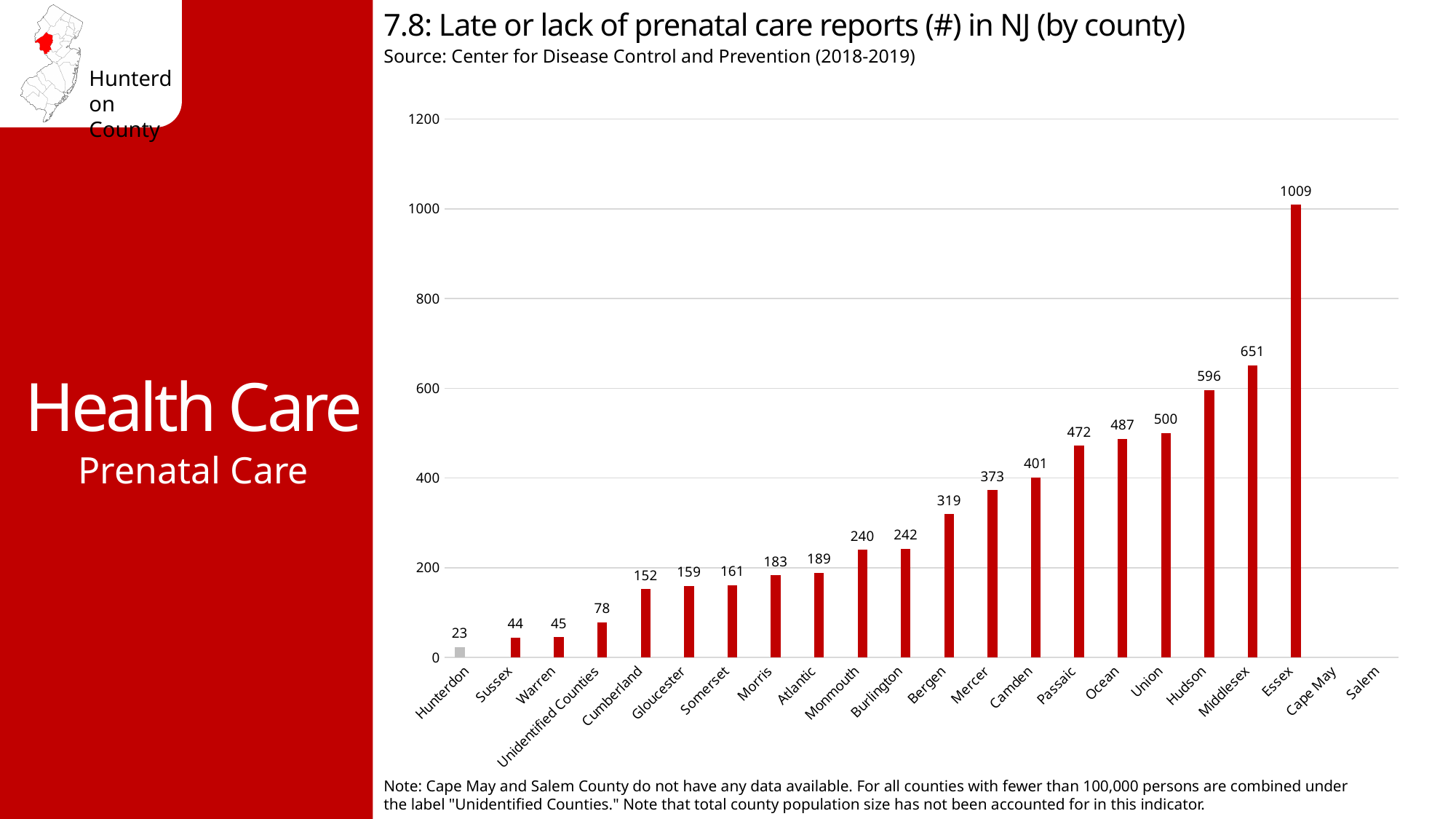
Which has a larger value, Hudson or Union? Hudson Is the value for Bergen greater or less than 400? less What kind of chart is shown on the slide? Bar chart Which county has the highest number of late or lack of prenatal care reports? Essex What is the number of late or lack of prenatal care reports for Hunterdon? 23 What is the value shown for Unidentified Counties? 78 What is the difference between the values for Essex and Middlesex? 358 What is the value shown for Essex? 1009 How many county categories are labeled on the x axis? 22 Among counties with a plotted value, which has the lowest number of reports? Hunterdon Do the values generally rise or fall from left to right along the x axis (excluding Cape May and Salem)? Rise What is the value shown for Middlesex? 651